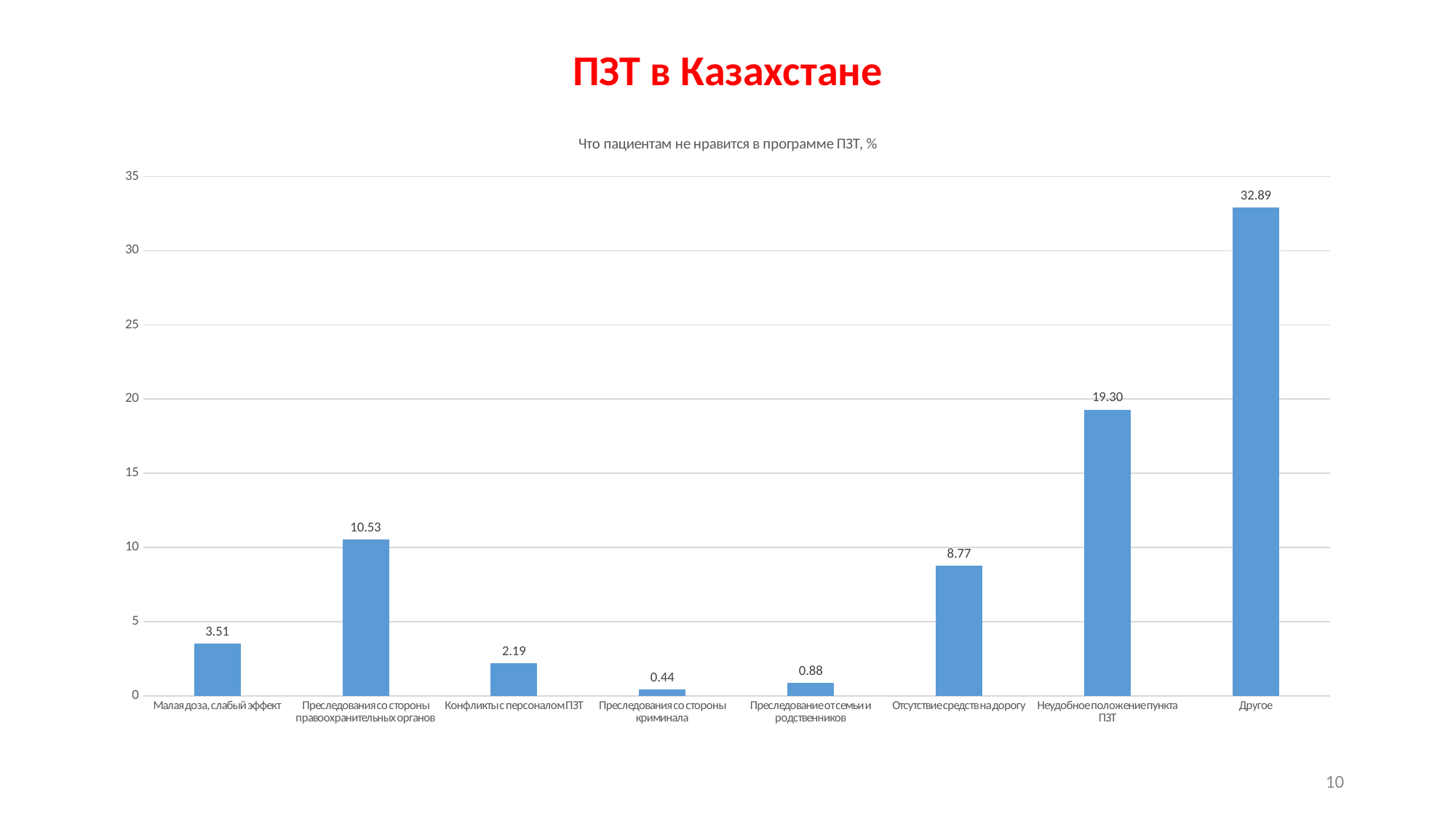
Which is larger: the value for "Малая доза, слабый эффект" or the value for "Конфликты с персоналом ПЗТ"? Малая доза, слабый эффект What is the difference between the values for "Другое" and "Неудобное положение пункта ПЗТ"? 13.59 What kind of chart is shown on the slide? bar chart What is the value for "Отсутствие средств на дорогу"? 8.77 Which category has the highest value? Другое How many categories are shown on the chart? 8 What is the value for "Преследования со стороны правоохранительных органов"? 10.53 Is the value for "Неудобное положение пункта ПЗТ" greater or less than 15? greater What is the value for "Преследование от семьи и родственников"? 0.88 Which category has the lowest value? Преследования со стороны криминала What is the title of the chart? Что пациентам не нравится в программе ПЗТ, % What is the value for "Другое"? 32.89